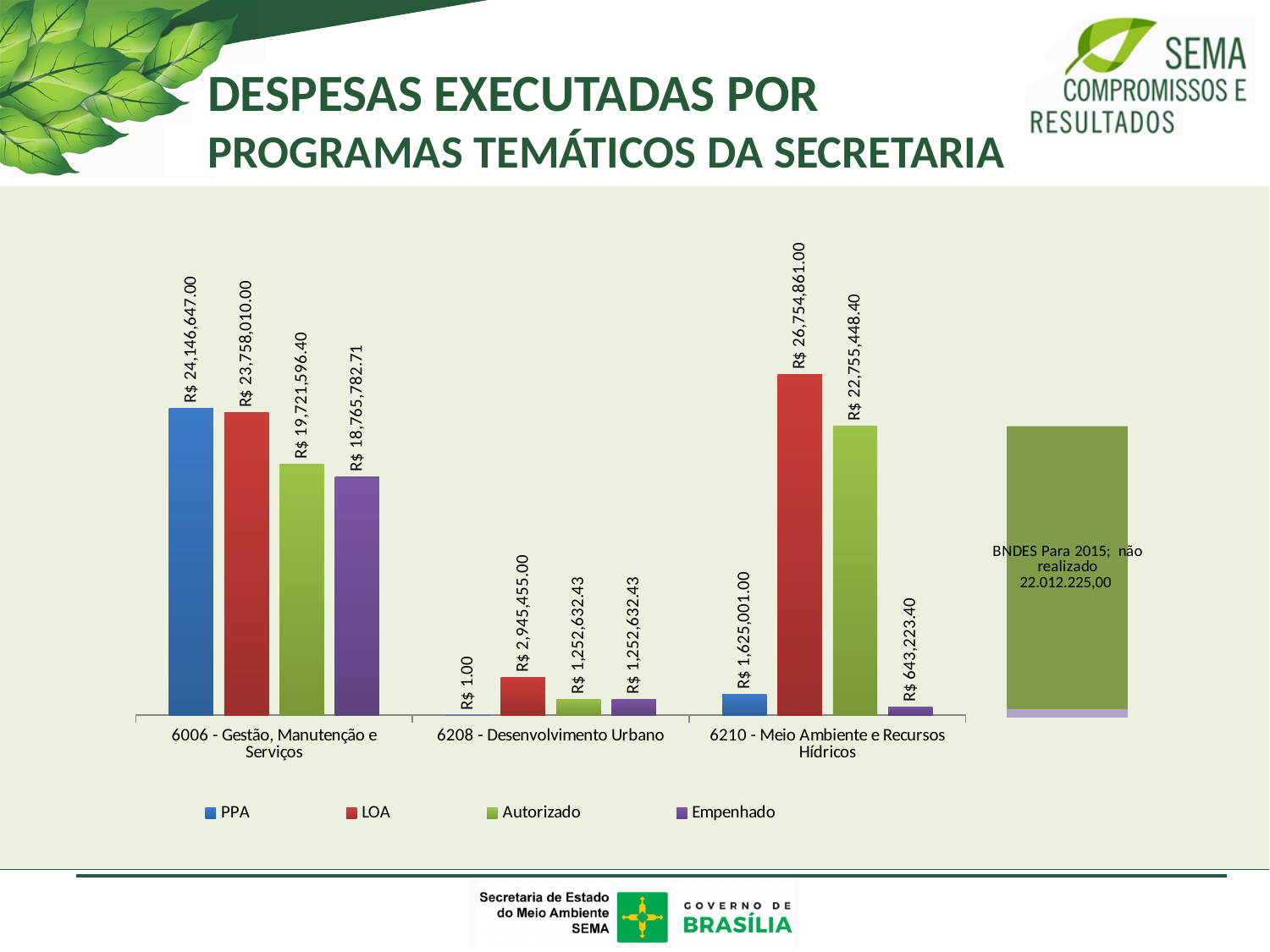
What is the PPA value for 6006 - Gestão, Manutenção e Serviços? R$ 24,146,647.00 What is the PPA value for 6208 - Desenvolvimento Urbano? R$ 1.00 What kind of chart is shown on the slide? Bar chart What is the LOA value for 6210 - Meio Ambiente e Recursos Hídricos? R$ 26,754,861.00 What is the difference between the PPA and LOA values for 6006 - Gestão, Manutenção e Serviços? R$ 388,637.00 How many programs (categories) are shown on the x axis of the chart? 3 What is the difference between the LOA and Autorizado values for 6210 - Meio Ambiente e Recursos Hídricos? R$ 3,999,412.60 Which program has the highest LOA value? 6210 - Meio Ambiente e Recursos Hídricos What is the Empenhado value for 6208 - Desenvolvimento Urbano? R$ 1,252,632.43 How many series does the chart legend list? 4 Which program has the lowest Empenhado value? 6210 - Meio Ambiente e Recursos Hídricos Which is larger for 6210 - Meio Ambiente e Recursos Hídricos: the PPA value or the Autorizado value? Autorizado